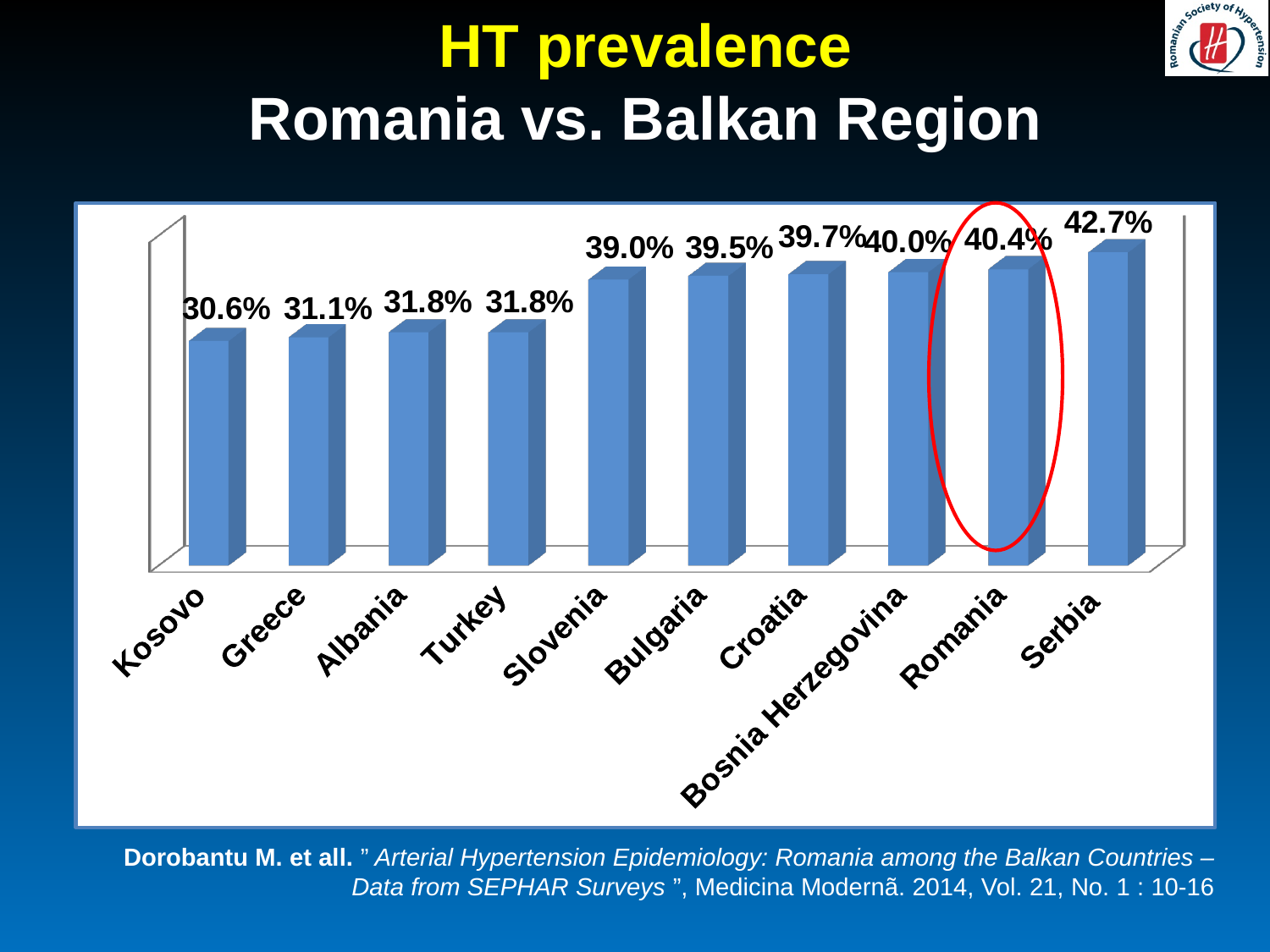
Which country has the lowest HT prevalence in the chart? Kosovo What is the difference between the HT prevalence of Serbia and Kosovo? 12.1% What is the HT prevalence value shown for Romania? 40.4% Which country's bar is circled in red on the chart? Romania What type of chart is shown on the slide? Bar chart What is the HT prevalence value shown for Bosnia Herzegovina? 40.0% Which country has the highest HT prevalence in the chart? Serbia What is the HT prevalence value shown for Kosovo? 30.6% Which has a higher HT prevalence, Bulgaria or Turkey? Bulgaria What is the HT prevalence value shown for Slovenia? 39.0% How many countries are shown in the chart? 10 What is the difference between the HT prevalence of Romania and Greece? 9.3%